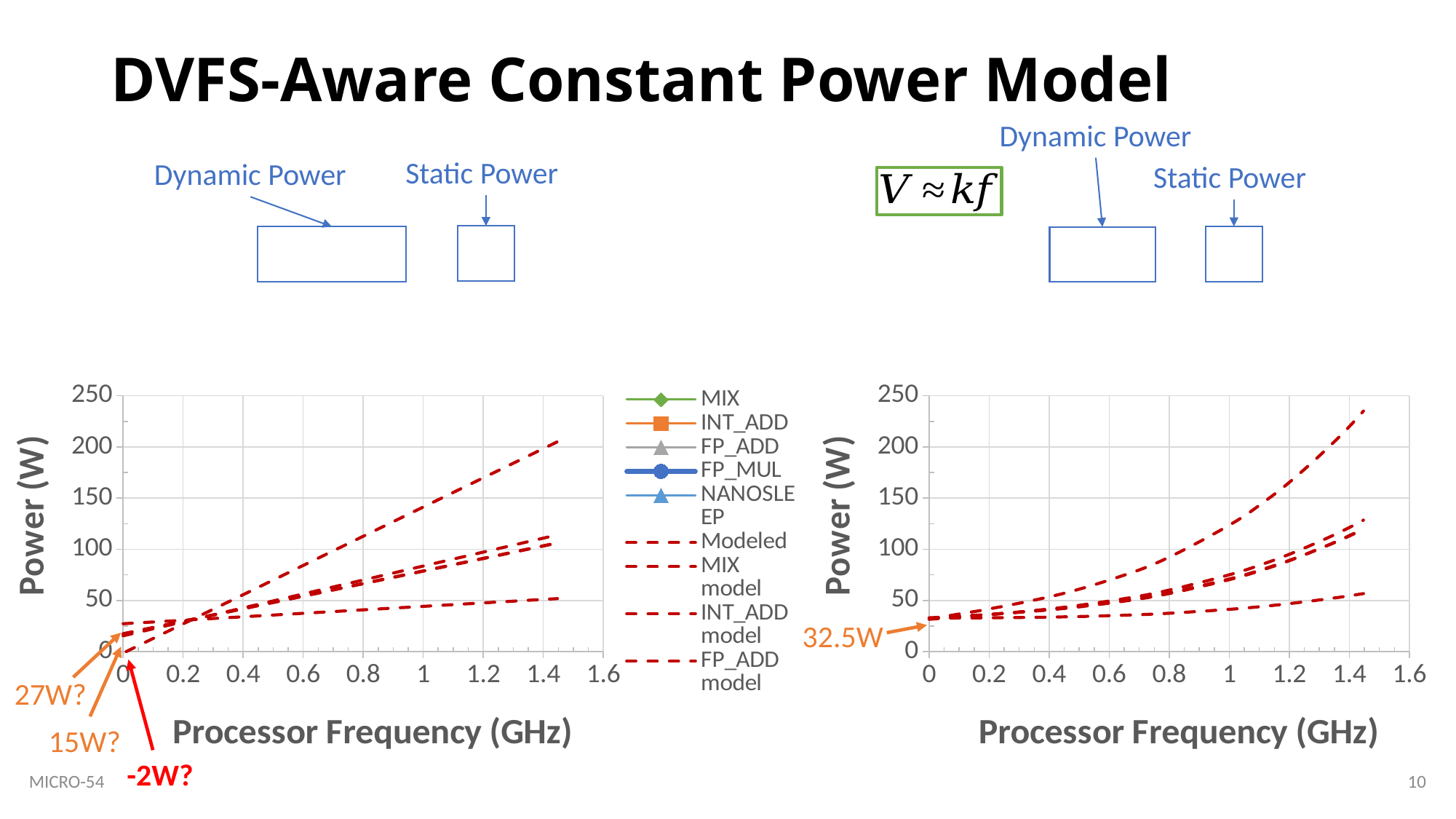
In the left chart, do the dashed modeled lines rise or fall as processor frequency increases? rise How many entries does the legend of the left chart list? 9 In the right chart, is the value of the lowest dashed curve at 1.4 GHz greater or less than 100? less In the right chart, what power value is annotated at the zero-frequency intercept of the curves? 32.5W What is the maximum value shown on the y-axis of the right chart? 250 What kind of chart is the left chart on the slide? line chart In the left chart, what is the highest annotated intercept value shown in orange? 27W? What is the x-axis label of the right chart? Processor Frequency (GHz) In the left chart, which dashed line is higher at 1.4 GHz: the topmost line or the bottommost line? the topmost line In the right chart, is the value of the topmost dashed curve at 1.4 GHz greater or less than 200? greater In the left chart, is the value of the topmost dashed line at 1.4 GHz greater or less than 150? greater In the left chart, what is the lowest annotated intercept value shown in red? -2W?